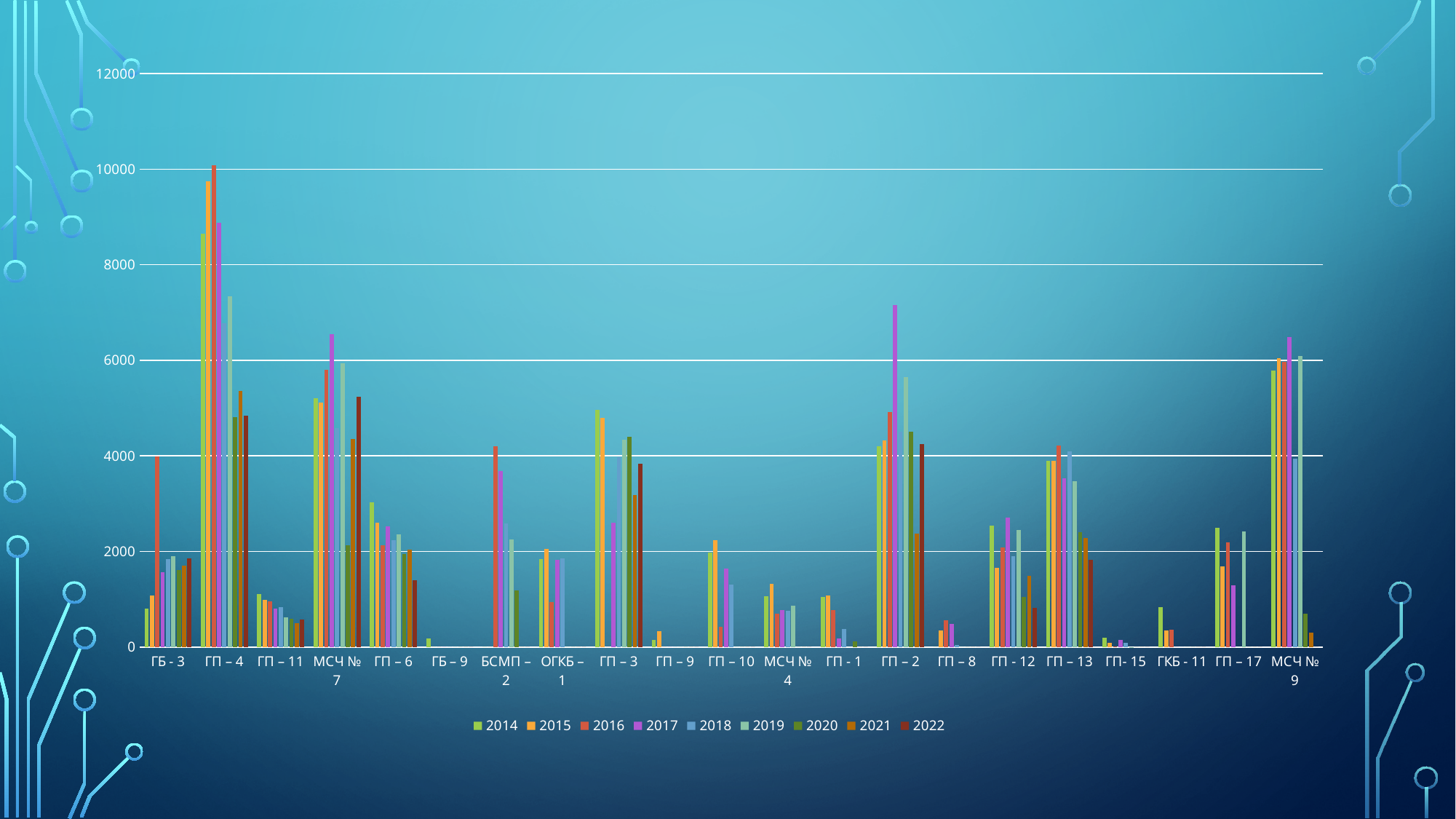
Which series has the highest value for ГП – 2? 2017 Is the 2016 value for ГП – 4 greater or less than 8000? greater Is the 2014 value for ГП – 3 greater or less than 4000? greater Is the 2017 value for БСМП – 2 greater or less than 4000? less Which category has the tallest bar in the chart? ГП – 4 What kind of chart is shown on the slide? bar chart How many series does the legend list? 9 How many categories are shown along the x axis? 21 Which year is listed first in the legend? 2014 Which is larger: the 2016 value for ГП – 4 or the 2016 value for МСЧ № 7? ГП – 4